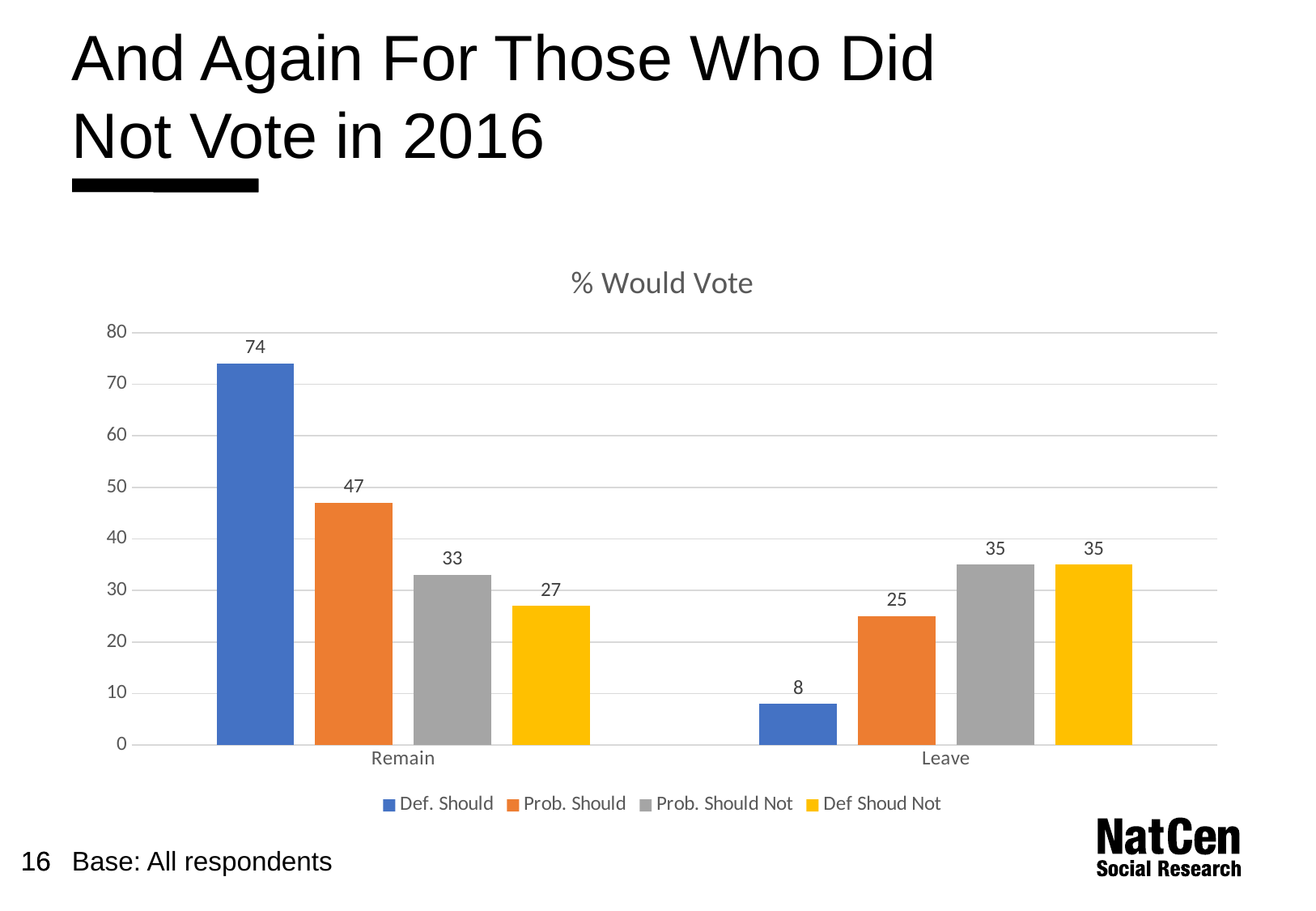
What is the title of the chart? % Would Vote Which is larger: Prob. Should Not for Remain or Prob. Should Not for Leave? Prob. Should Not for Leave What is the value for Def Shoud Not in the Remain category? 27 How many series does the legend list? 4 Which series has the highest value in the Remain category? Def. Should What is the difference between the Def. Should values for Remain and Leave? 66 How many categories are shown on the x axis? 2 What is the value for Prob. Should in the Leave category? 25 What kind of chart is shown on the slide? Bar chart What is the value for Def. Should in the Remain category? 74 Which series has the lowest value in the Leave category? Def. Should Is the value for Prob. Should in the Remain category greater or less than 40? greater